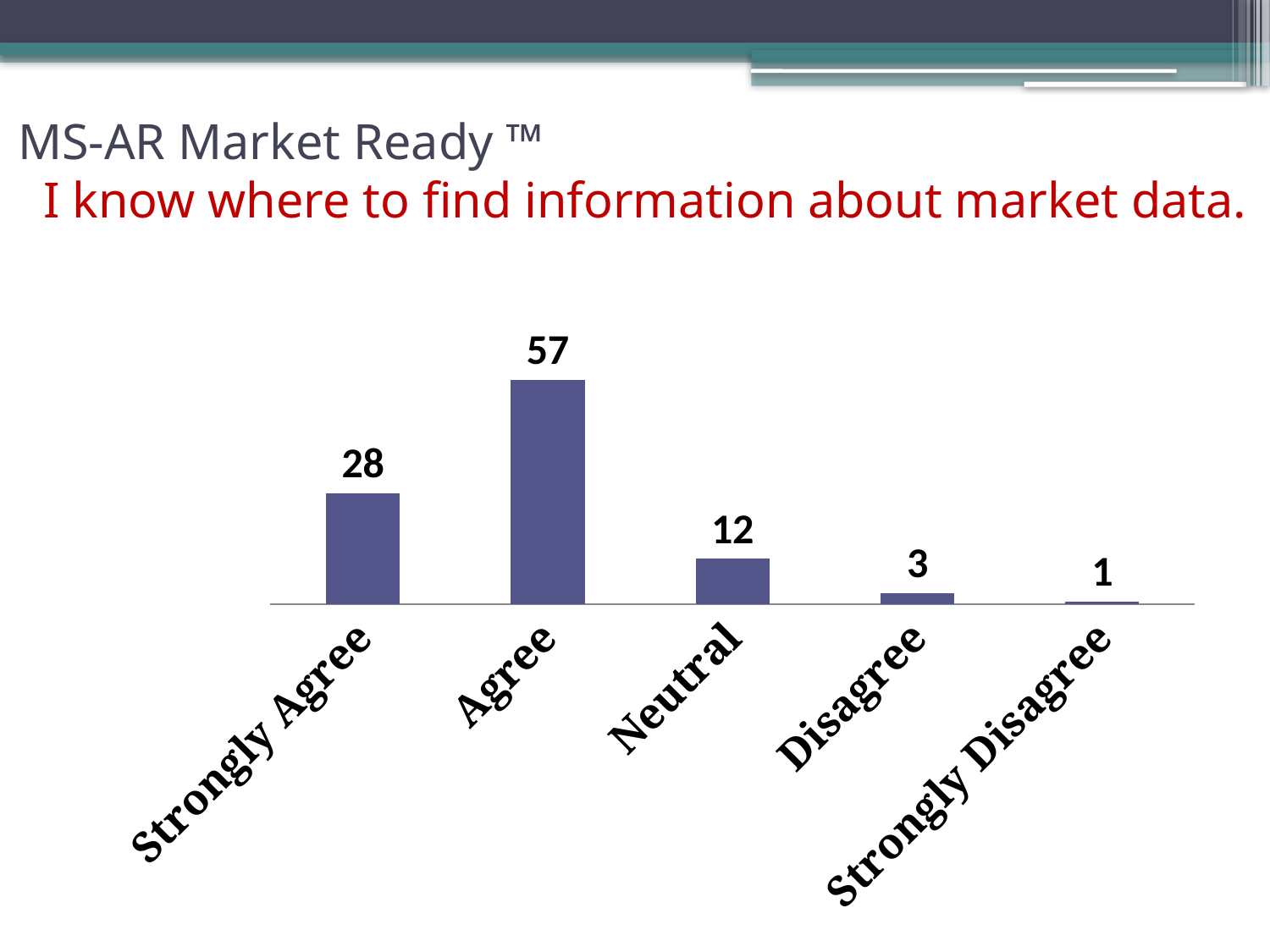
What is the value for Agree? 57 What is the difference between the values for Neutral and Disagree? 9 Which is larger, the value for Strongly Agree or the value for Neutral? Strongly Agree What is the value for Strongly Agree? 28 Which category has the highest value? Agree What is the value for Strongly Disagree? 1 What kind of chart is shown on the slide? Bar chart Which category has the lowest value? Strongly Disagree What is the difference between the values for Agree and Strongly Agree? 29 How many categories are shown on the x axis? 5 What is the value for Neutral? 12 What is the total of all five bar values? 101